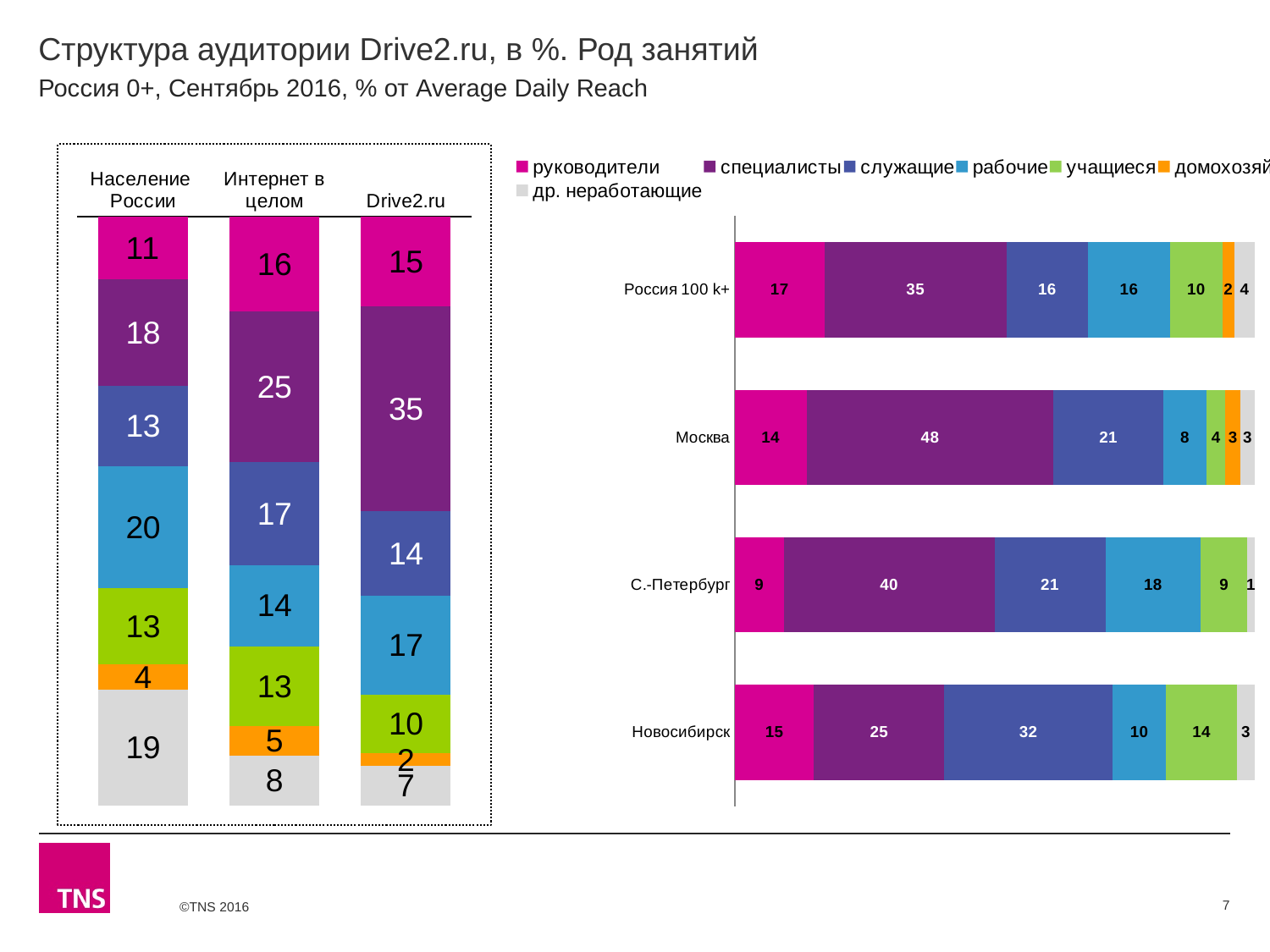
In the right chart, which category has the lowest value for руководители? С.-Петербург In the right chart, what is the value for служащие for Новосибирск? 32 In the left chart, what is the value for рабочие in the Население России bar? 20 In the right chart, which is larger: рабочие for С.-Петербург or рабочие for Москва? С.-Петербург How many categories (bars) does the right chart show? 4 In the left chart, what is the difference between the специалисты values for Drive2.ru and Население России? 17 In the left chart, what is the value for специалисты in the Drive2.ru bar? 35 What type of chart is the right chart? Stacked bar chart In the right chart, which city has the highest value for специалисты? Москва How many series does the legend of the right chart list? 7 In the left chart, what is the value for руководители in the Интернет в целом bar? 16 In the right chart, what is the value for специалисты for Москва? 48